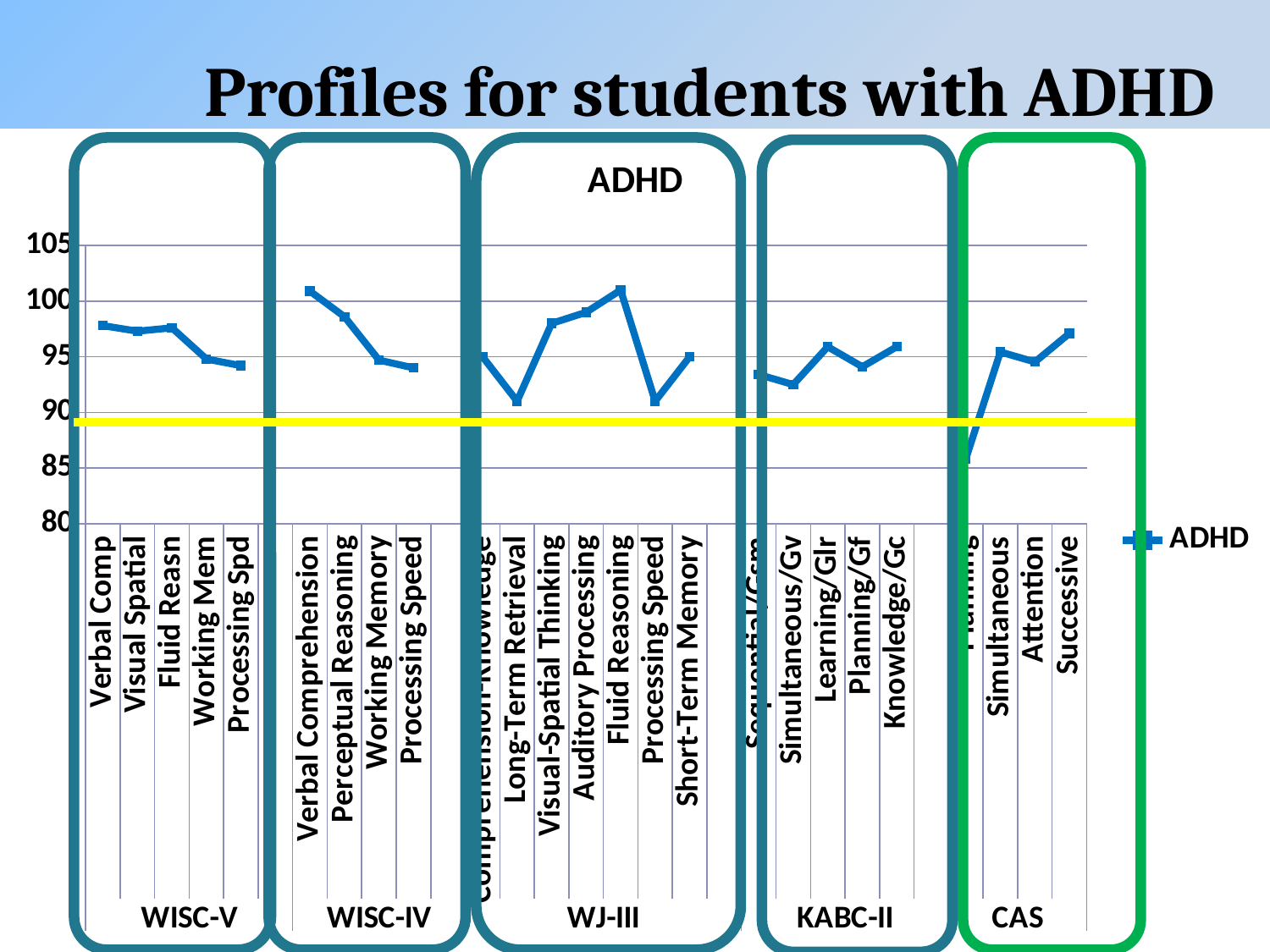
How many categories are plotted in the WISC-IV section of the chart? 4 What is the name of the series shown in the legend? ADHD Which is larger in the WJ-III section: Fluid Reasoning or Processing Speed? Fluid Reasoning How many series does the legend list? 1 Is the value for Processing Speed in the WJ-III section greater or less than 95? less Across the WISC-IV categories from Verbal Comprehension to Processing Speed, do the values rise or fall? fall Is the value for Successive (CAS) greater or less than 95? greater How many categories are plotted in the WISC-V section of the chart? 5 Is the value for Simultaneous/Gv (KABC-II) greater or less than 95? less What kind of chart is shown on the slide? line chart Which is larger in the WISC-IV section: Verbal Comprehension or Processing Speed? Verbal Comprehension